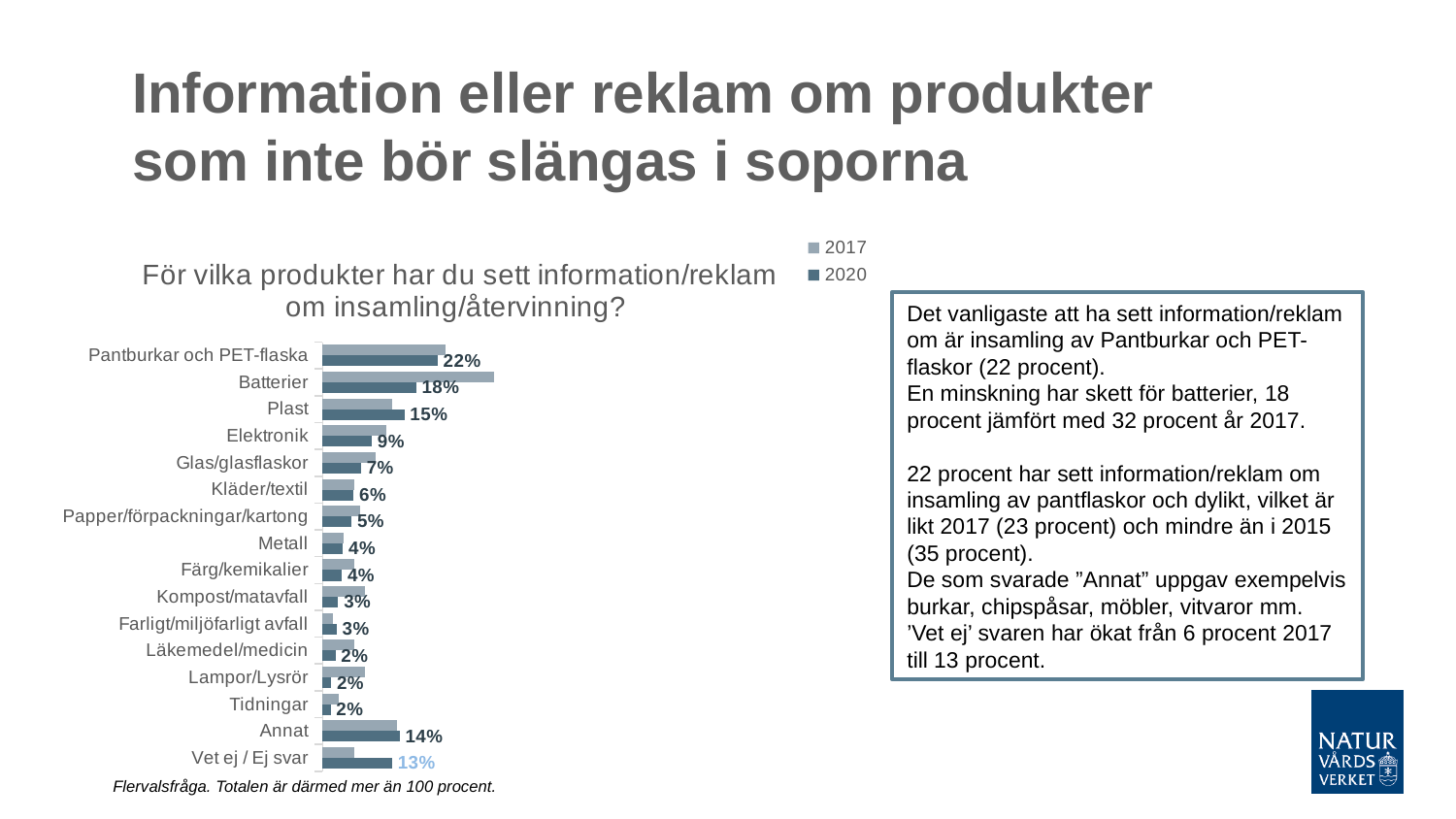
Which has the larger 2020 value, Plast or Glas/glasflaskor? Plast How many series does the legend list? 2 What is the 2020 value for Batterier? 18% For Batterier, is the 2017 bar or the 2020 bar longer? 2017 How many categories are shown in the chart? 16 What is the difference between the 2020 values for Pantburkar och PET-flaska and Batterier? 4 percentage points What is the 2020 value for Elektronik? 9% What kind of chart is shown on the slide? Bar chart What is the 2020 value for Annat? 14% What is the 2020 value for Vet ej / Ej svar? 13% What is the 2020 value for Pantburkar och PET-flaska? 22% Which category has the highest 2020 value? Pantburkar och PET-flaska